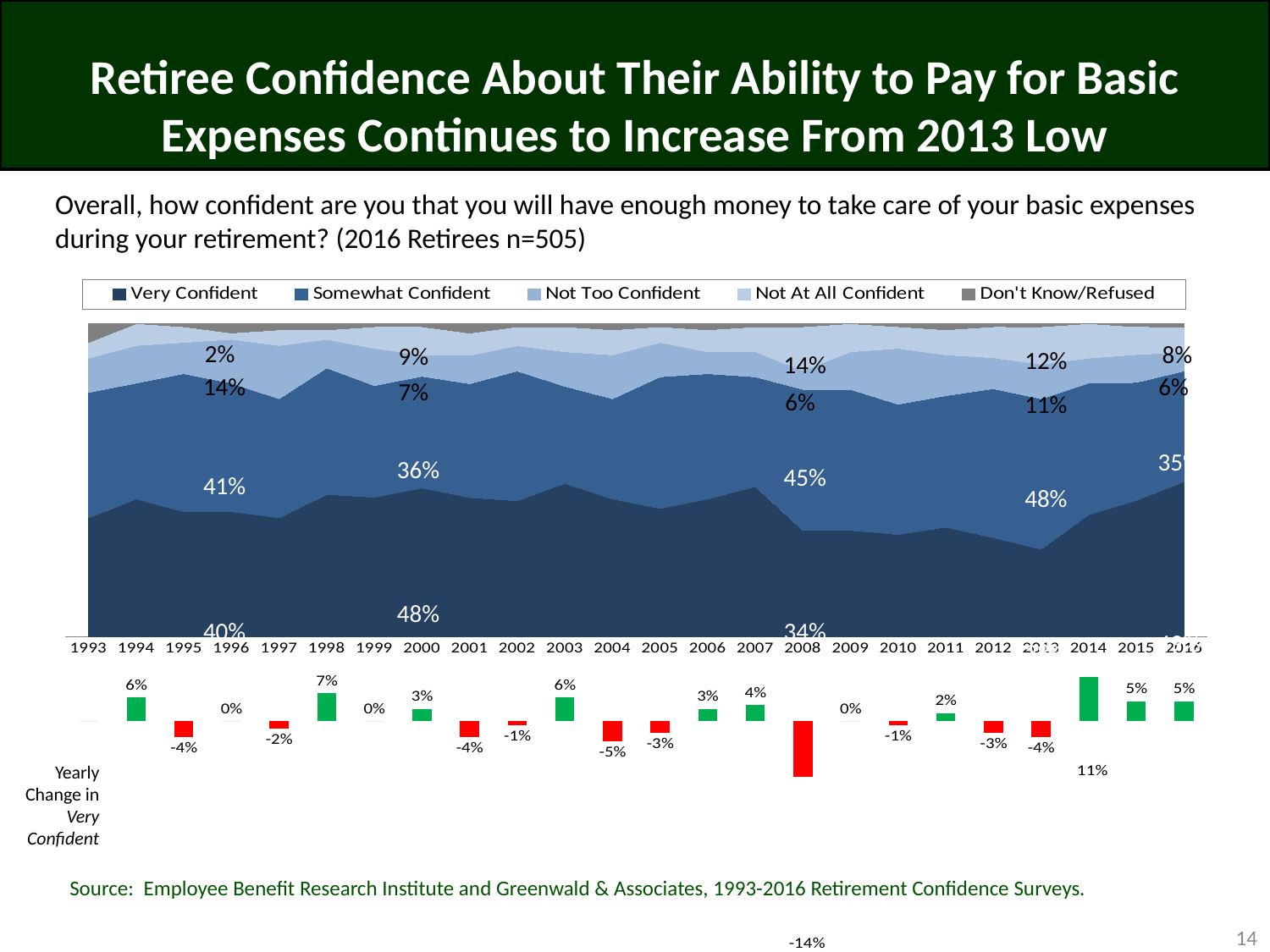
In the top stacked area chart, what percentage of retirees were Very Confident in 2000? 48% In the bottom 'Yearly Change in Very Confident' chart, which year has the lowest value? 2008 What kind of chart is the bottom 'Yearly Change in Very Confident' chart? Bar chart In the top stacked area chart, what percentage of retirees were Not Too Confident in 1996? 14% In the bottom 'Yearly Change in Very Confident' chart, what is the value for 1998? 7% In the top stacked area chart, what percentage of retirees were Somewhat Confident in 2008? 45% In the bottom 'Yearly Change in Very Confident' chart, which year has the highest value? 2014 How many series does the legend of the top chart list? 5 In the bottom 'Yearly Change in Very Confident' chart, what is the value for 2008? -14% What kind of chart is the top chart on the slide? Stacked area chart In the top stacked area chart, what percentage of retirees were Not At All Confident in 2013? 12% In the bottom 'Yearly Change in Very Confident' chart, what is the difference between the 2014 value and the 2015 value? 6 percentage points